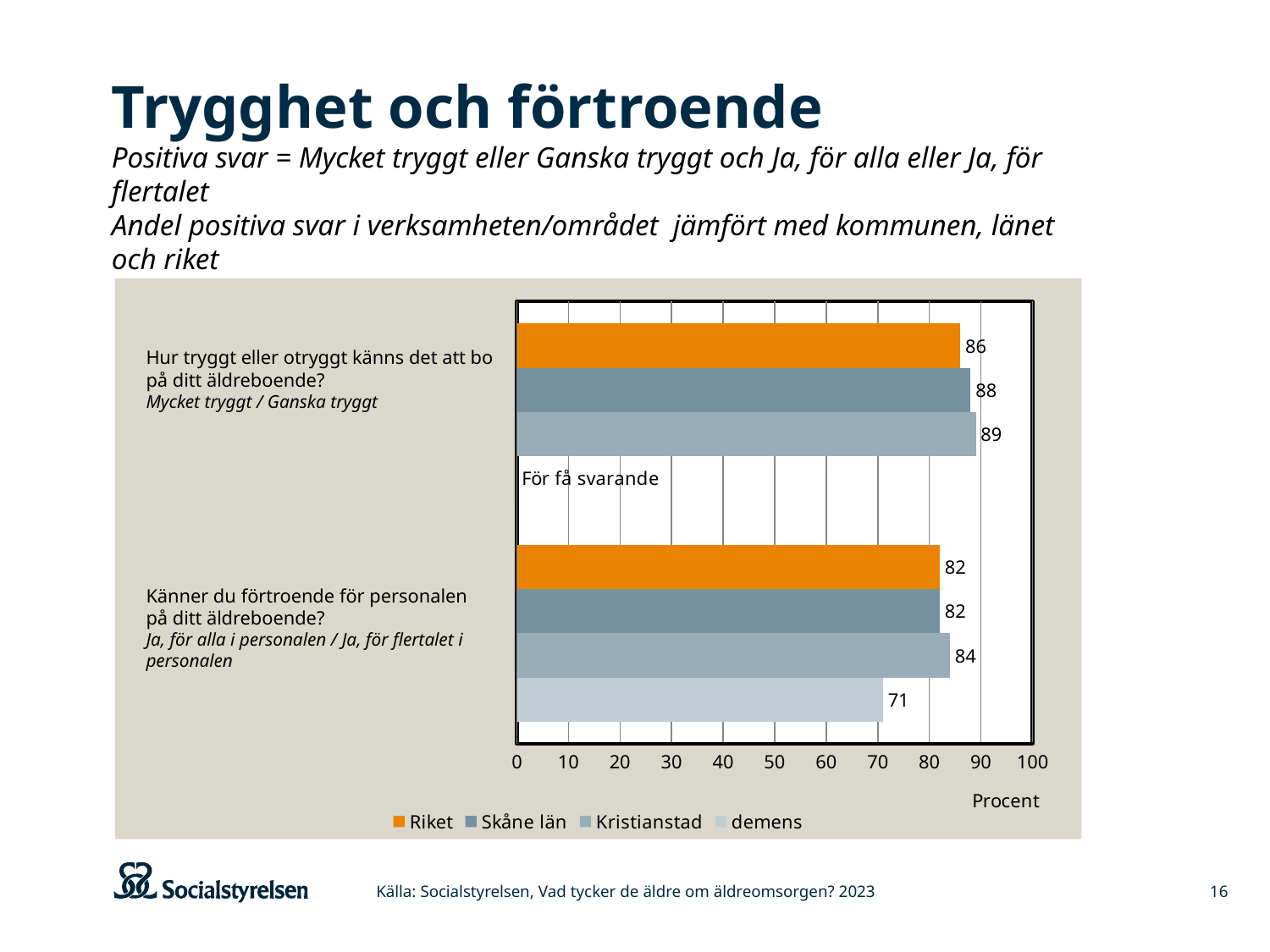
What is the value for Skåne län on the question "Känner du förtroende för personalen på ditt äldreboende?"? 82 What is the value for demens on the question "Känner du förtroende för personalen på ditt äldreboende?"? 71 Which is larger on the question "Hur tryggt eller otryggt känns det att bo på ditt äldreboende?": Riket or Skåne län? Skåne län What is the label on the x axis of the chart? Procent Which series has the highest value on the question "Hur tryggt eller otryggt känns det att bo på ditt äldreboende?"? Kristianstad What is the value for Riket on the question "Hur tryggt eller otryggt känns det att bo på ditt äldreboende?"? 86 What is the difference between the Kristianstad and demens values on the question "Känner du förtroende för personalen på ditt äldreboende?"? 13 What is the value for Kristianstad on the question "Hur tryggt eller otryggt känns det att bo på ditt äldreboende?"? 89 Which series has the lowest value on the question "Känner du förtroende för personalen på ditt äldreboende?"? demens How many series does the legend list? 4 What kind of chart is shown on the slide? Bar chart What is shown for the demens series on the question "Hur tryggt eller otryggt känns det att bo på ditt äldreboende?"? För få svarande